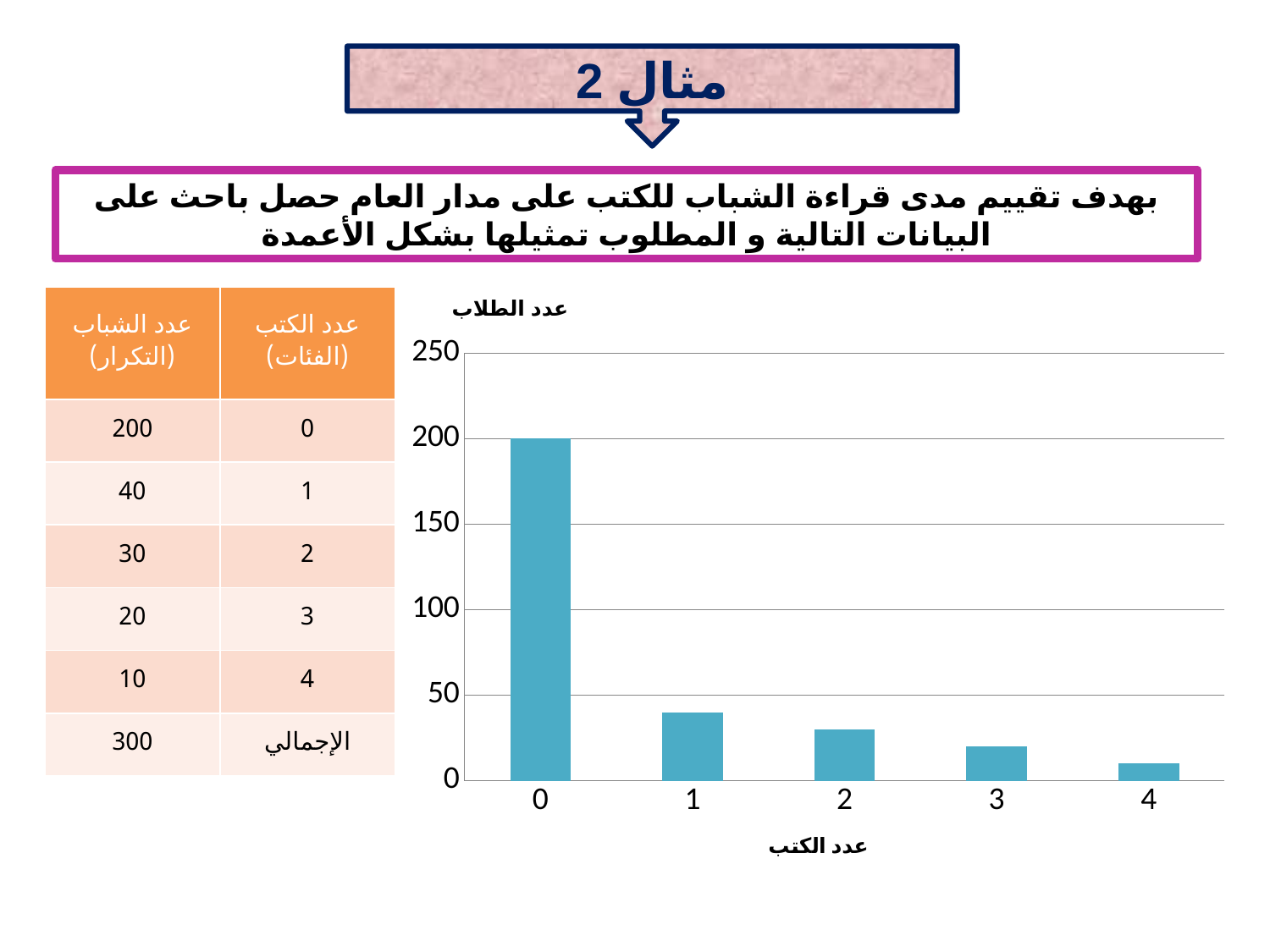
Which category has the lowest bar? 4 What kind of chart is shown on the slide? bar chart What is the value of the bar for category 0 (عدد الكتب = 0)? 200 How many categories are plotted on the x axis of the bar chart? 5 Which category has the highest bar? 0 What is the difference between the value for category 0 and the value for category 1? 160 Do the bar values rise or fall as the number of books (عدد الكتب) increases along the x axis? fall Is the value for category 1 greater or less than 50? less What is the value of the bar for category 4 (عدد الكتب = 4)? 10 What is the value of the bar for category 1 (عدد الكتب = 1)? 40 Is the value for category 0 greater or less than 150? greater Which is larger, the bar for category 2 or the bar for category 3? category 2